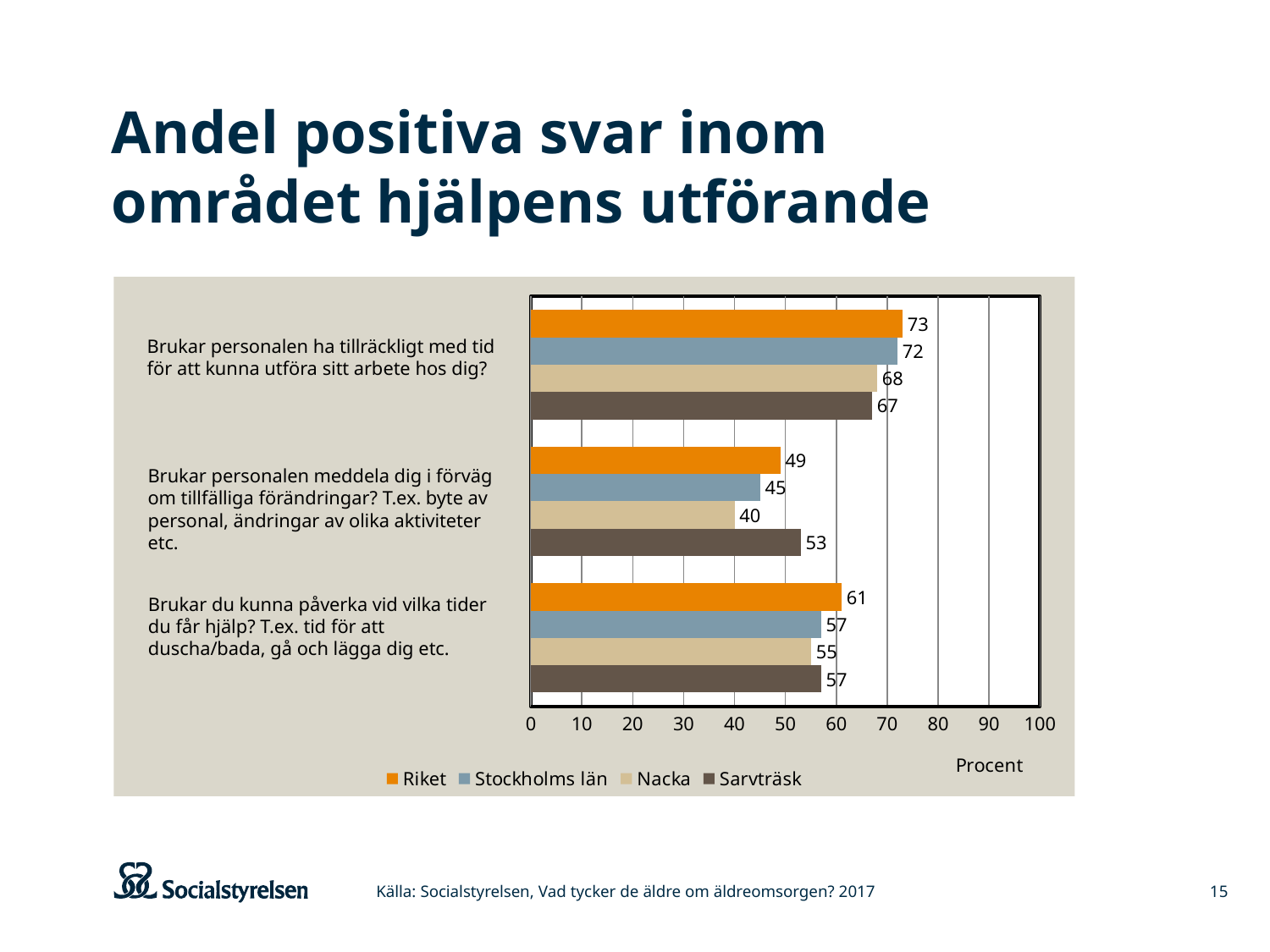
What kind of chart is shown on the slide? Bar chart Which series has the highest value on the question 'Brukar personalen meddela dig i förväg om tillfälliga förändringar?' Sarvträsk How many questions (categories) are shown on the chart? 3 What is the value for Sarvträsk on the question 'Brukar du kunna påverka vid vilka tider du får hjälp?' 57 What is the value for Nacka on the question 'Brukar personalen meddela dig i förväg om tillfälliga förändringar?' 40 What is the value for Riket on the question 'Brukar personalen ha tillräckligt med tid för att kunna utföra sitt arbete hos dig?' 73 What is the difference between Riket and Nacka on the question 'Brukar personalen meddela dig i förväg om tillfälliga förändringar?' 9 How many series does the legend list? 4 What is the unit shown on the horizontal axis of the chart? Procent Which series is shown in orange in the legend? Riket Which series has the lowest value on the question 'Brukar personalen ha tillräckligt med tid för att kunna utföra sitt arbete hos dig?' Sarvträsk Which is larger on the question 'Brukar du kunna påverka vid vilka tider du får hjälp?': Riket or Nacka? Riket